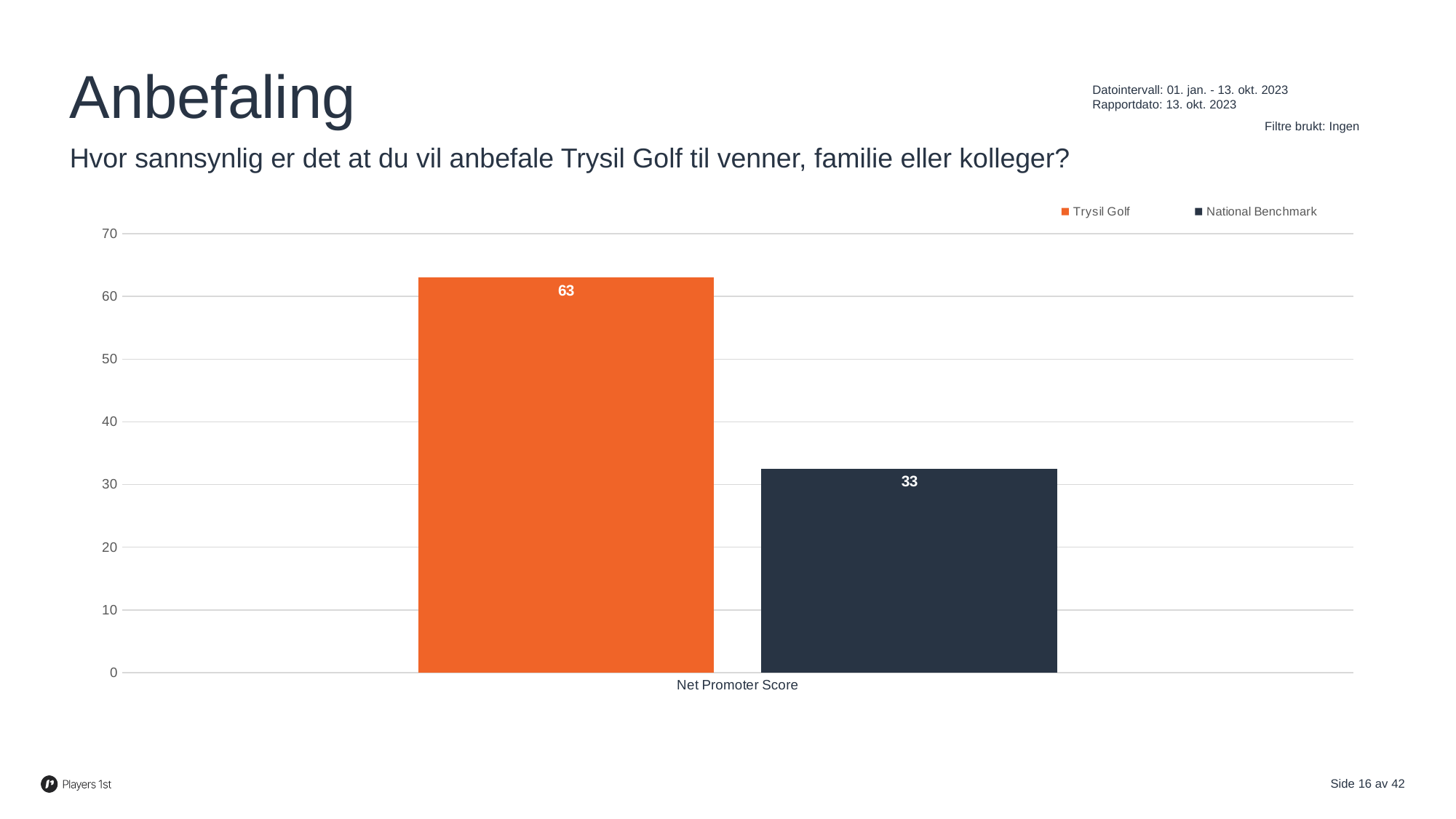
What kind of chart is shown on the slide? Bar chart How many series does the legend list? 2 What colour is the bar for Trysil Golf? Orange Which series has the higher Net Promoter Score? Trysil Golf What is the category label shown on the x axis? Net Promoter Score Is the value for National Benchmark greater or less than 40? less What is the difference between the Trysil Golf and National Benchmark Net Promoter Scores? 30 Is the value for Trysil Golf greater or less than 60? greater What is the Net Promoter Score for Trysil Golf? 63 Which series has the lower Net Promoter Score? National Benchmark Is the Net Promoter Score for Trysil Golf larger or smaller than that for National Benchmark? larger What is the Net Promoter Score for National Benchmark? 33